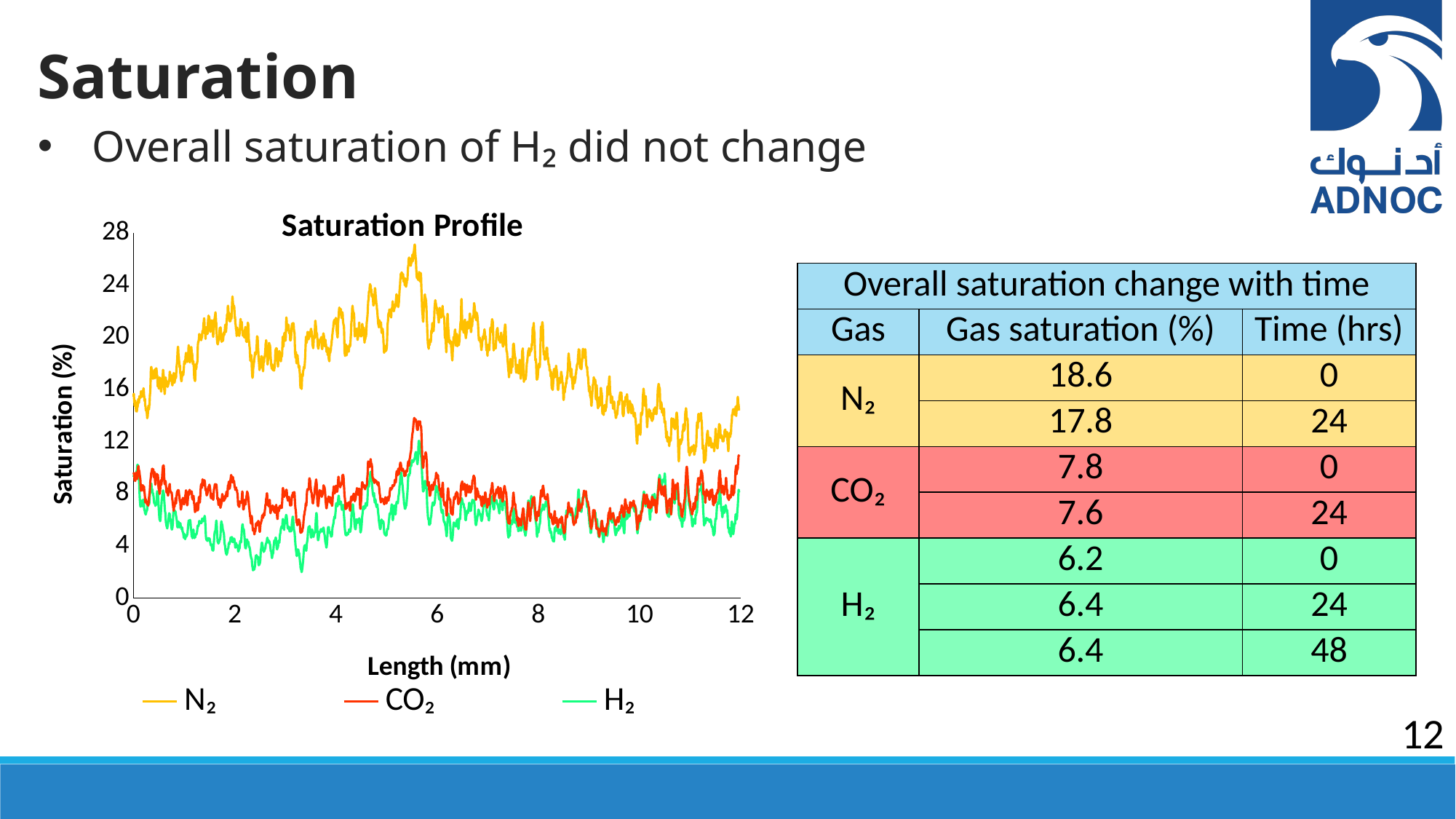
What kind of chart is the Saturation Profile chart? line chart In the Saturation Profile chart, does the N₂ series generally rise or fall between lengths of 6 mm and 12 mm? fall In the Saturation Profile chart, which series has the larger value at a length of 2 mm, N₂ or H₂? N₂ What colour is the N₂ line in the Saturation Profile chart? yellow How many series does the legend of the Saturation Profile chart list? 3 In the Saturation Profile chart, is the CO₂ saturation at length 0 mm greater or less than 4? greater In the Saturation Profile chart, is the lowest value of the H₂ series greater or less than 4? less What is the label of the x axis in the Saturation Profile chart? Length (mm) Which series in the Saturation Profile chart has the highest saturation values across the length? N₂ In the Saturation Profile chart, is the N₂ saturation at length 0 mm greater or less than 12? greater Which series in the Saturation Profile chart has the lowest saturation values across most of the length? H₂